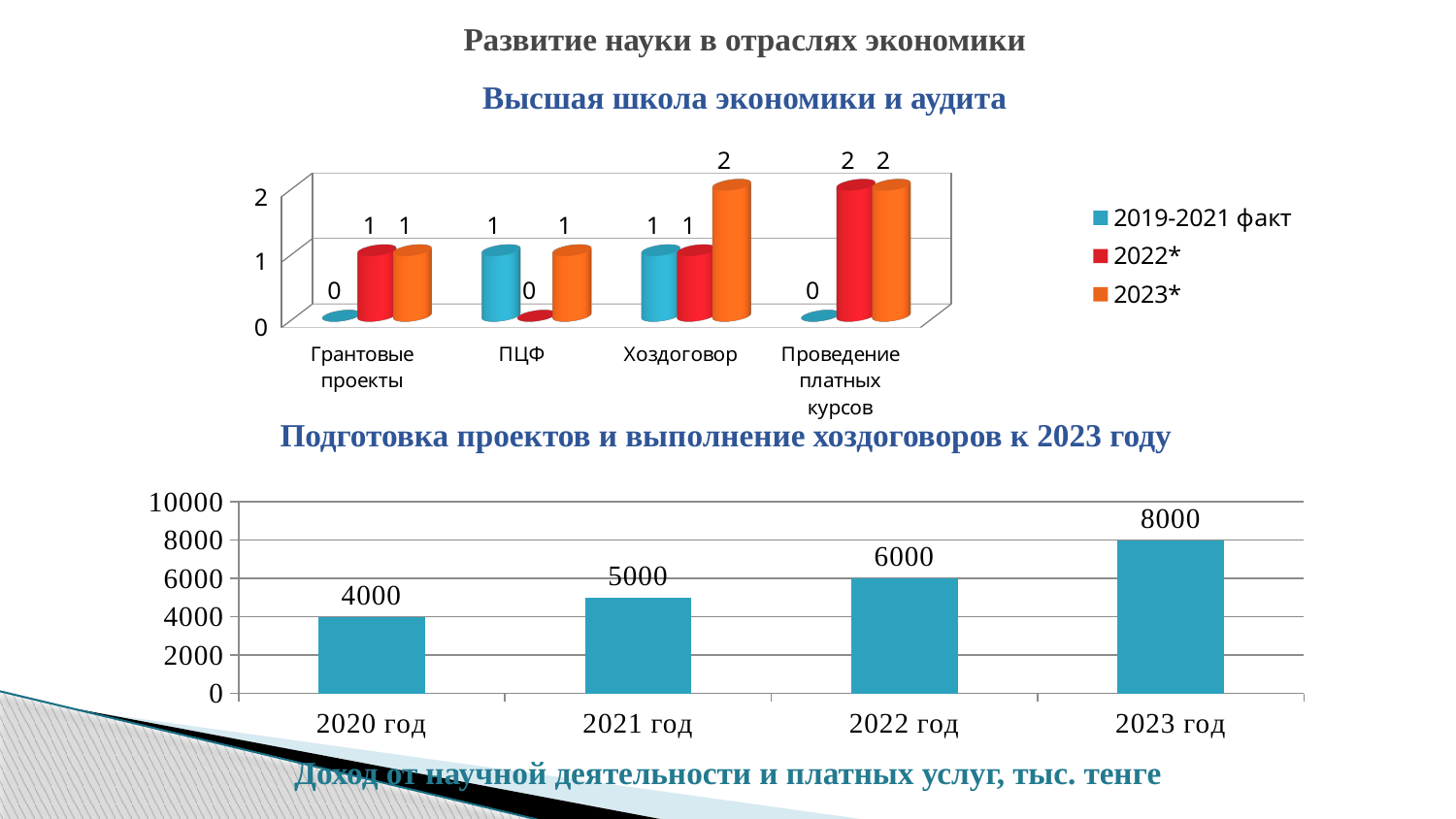
In the bottom chart, do the values rise or fall from 2020 год to 2023 год? rise In the top chart, what is the value for Хоздоговор in the 2023* series? 2 In the top chart, what is the value for ПЦФ in the 2022* series? 0 What kind of chart is the bottom chart? bar chart In the bottom chart, what is the value for 2023 год? 8000 In the bottom chart, what is the value for 2021 год? 5000 In the top chart, what is the value for Проведение платных курсов in the 2019-2021 факт series? 0 In the bottom chart, what is the difference between the values for 2023 год and 2022 год? 2000 How many categories are shown on the x axis of the top chart? 4 In the top chart, which is larger for Хоздоговор: the 2022* value or the 2023* value? 2023* In the bottom chart, which year has the lowest value? 2020 год How many series does the legend of the top chart list? 3